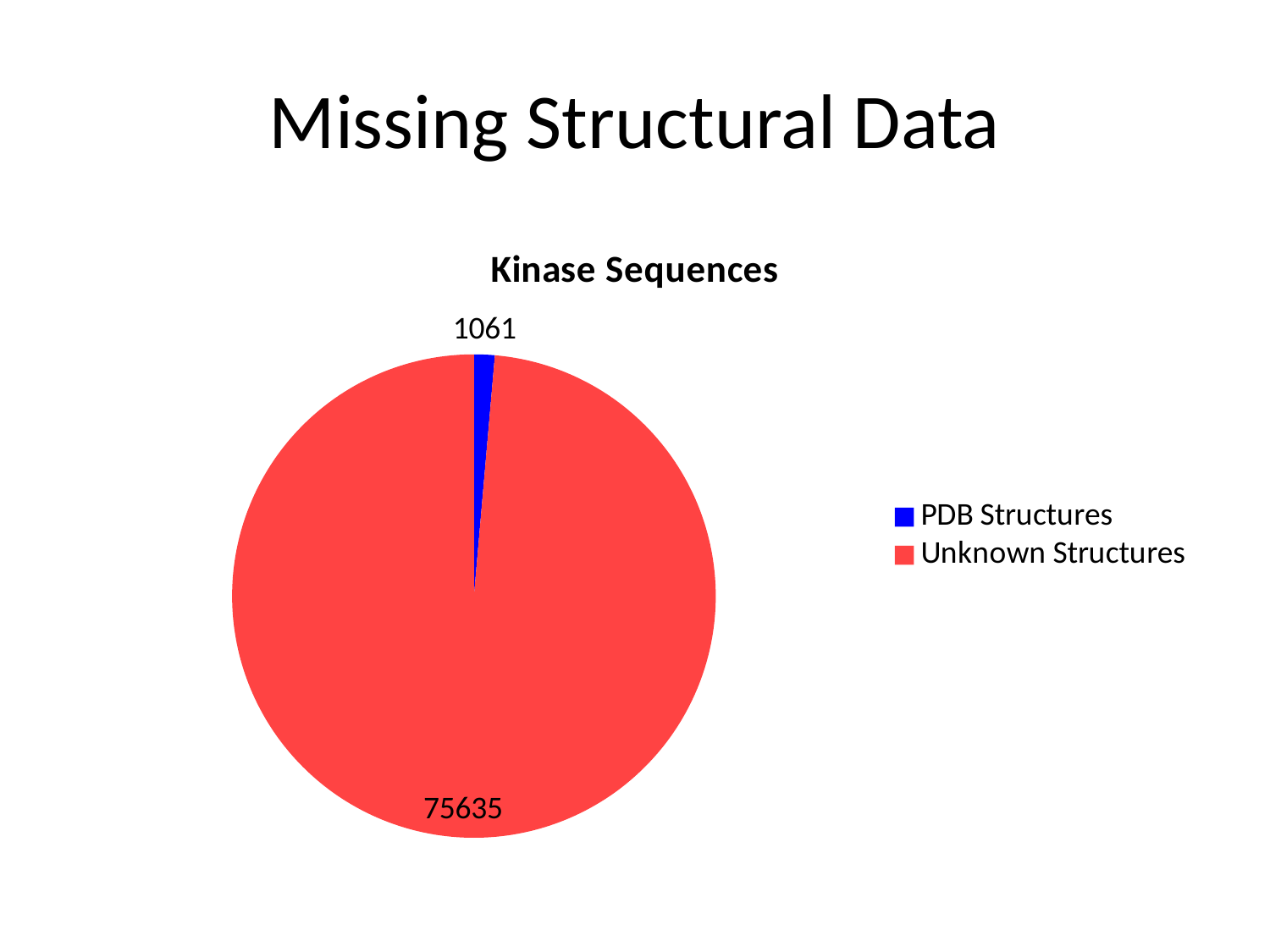
What is the value for Unknown Structures? 75635 Which category has the smallest slice? PDB Structures What type of chart is shown on the slide? pie chart How many slices does the pie chart have? 2 What is the title of the chart? Kinase Sequences Which category has the largest slice? Unknown Structures How many entries does the legend list? 2 What is the value for PDB Structures? 1061 What colour is the PDB Structures slice? blue Which is larger, PDB Structures or Unknown Structures? Unknown Structures What is the difference between the Unknown Structures value and the PDB Structures value? 74574 What is the total of the two slices in the pie chart? 76696